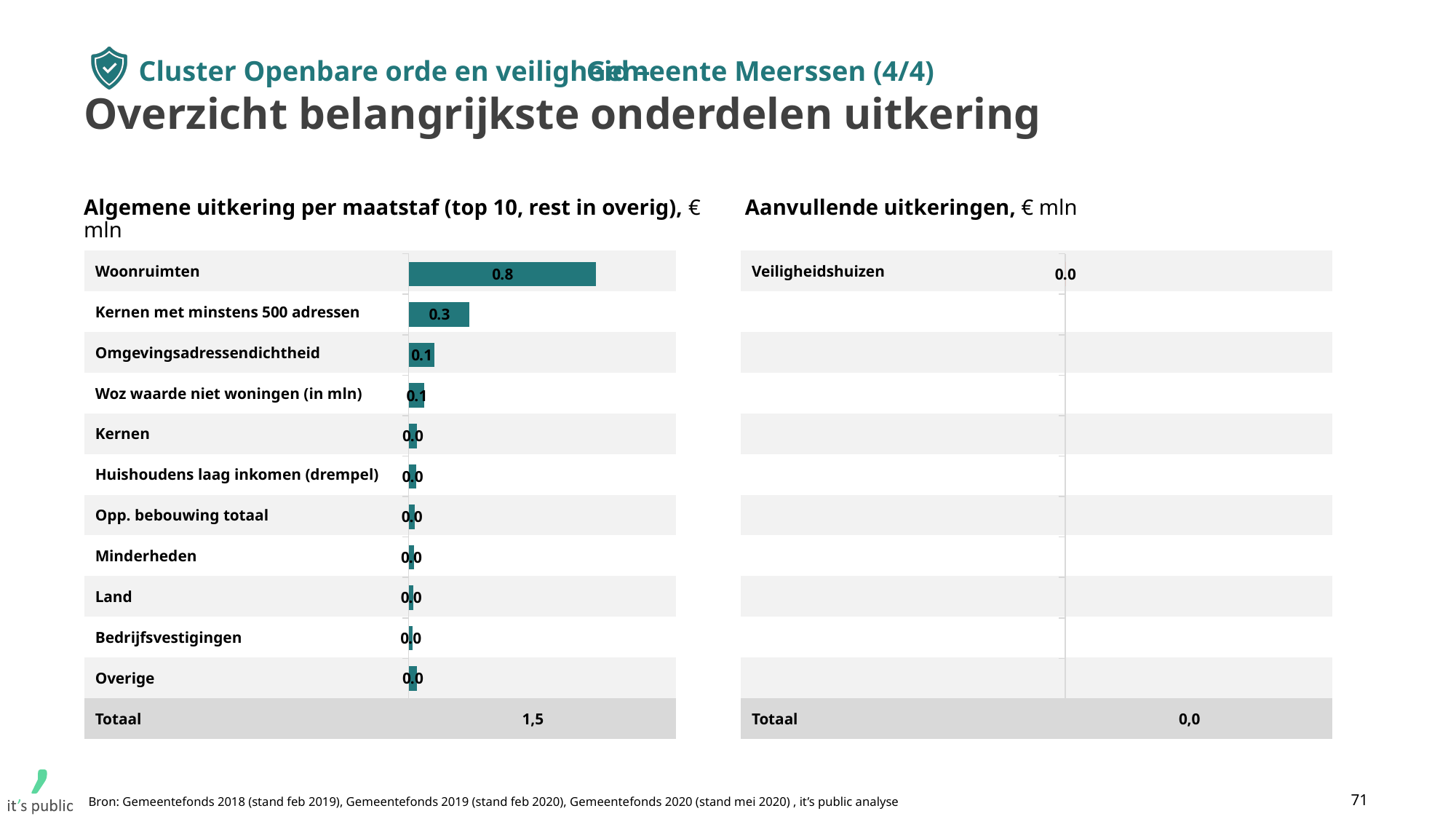
What kind of chart is 'Algemene uitkering per maatstaf'? Bar chart In the chart 'Algemene uitkering per maatstaf', which is larger: Woonruimten or Kernen met minstens 500 adressen? Woonruimten In the chart 'Algemene uitkering per maatstaf', what is the Totaal shown? 1,5 In the chart 'Algemene uitkering per maatstaf', what is the value for Woonruimten? 0.8 In the chart 'Algemene uitkering per maatstaf', what is the value for Omgevingsadressendichtheid? 0.1 In the chart 'Algemene uitkering per maatstaf', how many categories are shown (including Overige, excluding the Totaal row)? 11 In the chart 'Algemene uitkering per maatstaf', what is the value for Kernen met minstens 500 adressen? 0.3 In the chart 'Algemene uitkering per maatstaf', what is the difference between Woonruimten and Kernen met minstens 500 adressen? 0.5 In the chart 'Aanvullende uitkeringen', what is the value for Veiligheidshuizen? 0.0 In the chart 'Algemene uitkering per maatstaf', which category has the highest value? Woonruimten In the chart 'Aanvullende uitkeringen', how many categories are shown (excluding the Totaal row)? 1 In what unit are the values in the chart 'Aanvullende uitkeringen' expressed, according to its title? € mln